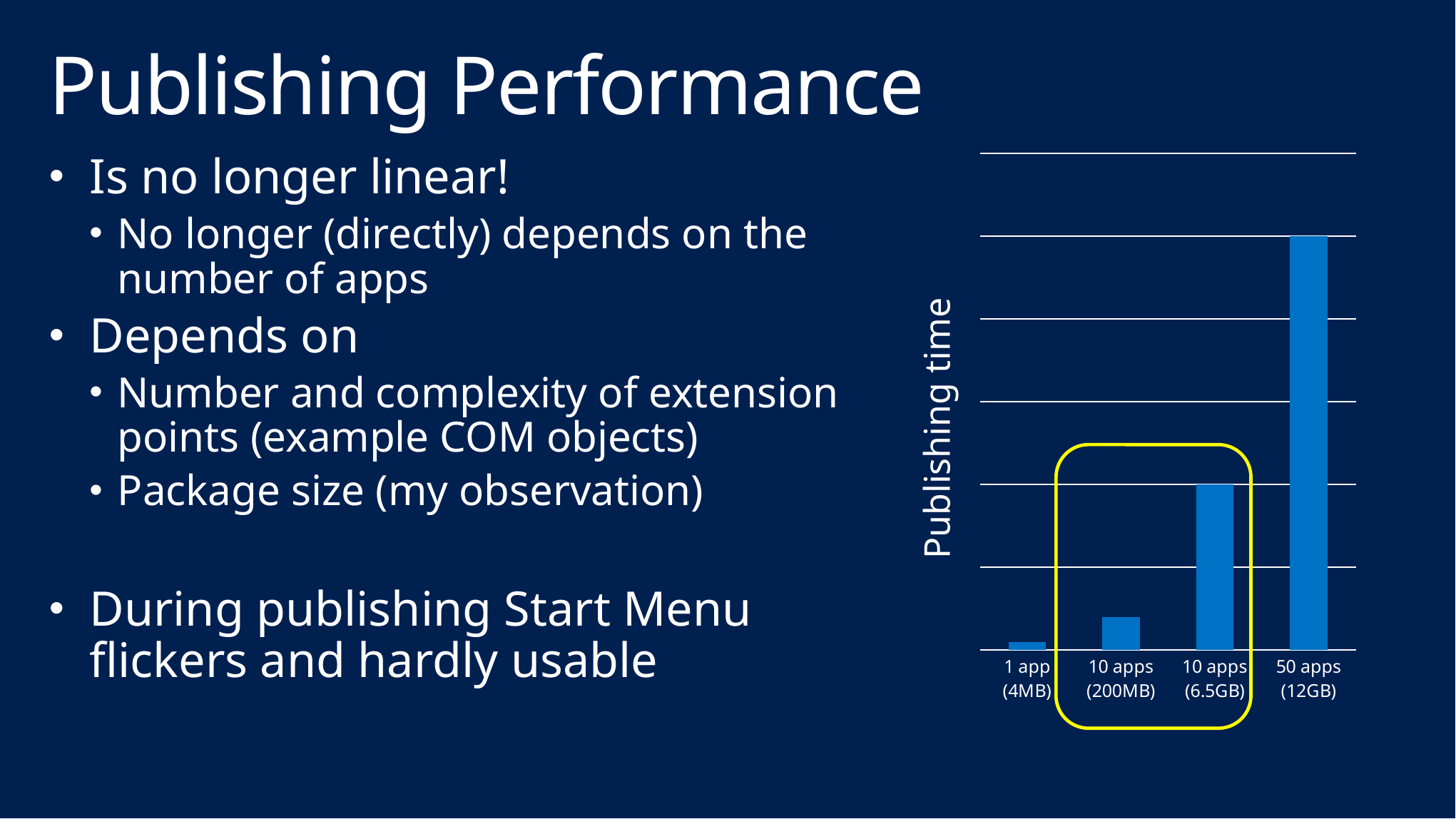
Which category has the highest publishing time in the chart? 50 apps (12GB) Which category has the second-highest bar in the chart? 10 apps (6.5GB) Which two categories are enclosed by the yellow rounded rectangle on the chart? 10 apps (200MB) and 10 apps (6.5GB) Do the bars rise or fall from left to right along the x axis? rise Which has the larger publishing time: 1 app (4MB) or 10 apps (200MB)? 10 apps (200MB) Which category has the lowest publishing time in the chart? 1 app (4MB) Which has the larger publishing time: 50 apps (12GB) or 10 apps (6.5GB)? 50 apps (12GB) What kind of chart is shown on the slide? bar chart Which has the larger publishing time: 10 apps (200MB) or 10 apps (6.5GB)? 10 apps (6.5GB) What is the label on the vertical axis of the chart? Publishing time How many categories (bars) does the chart show? 4